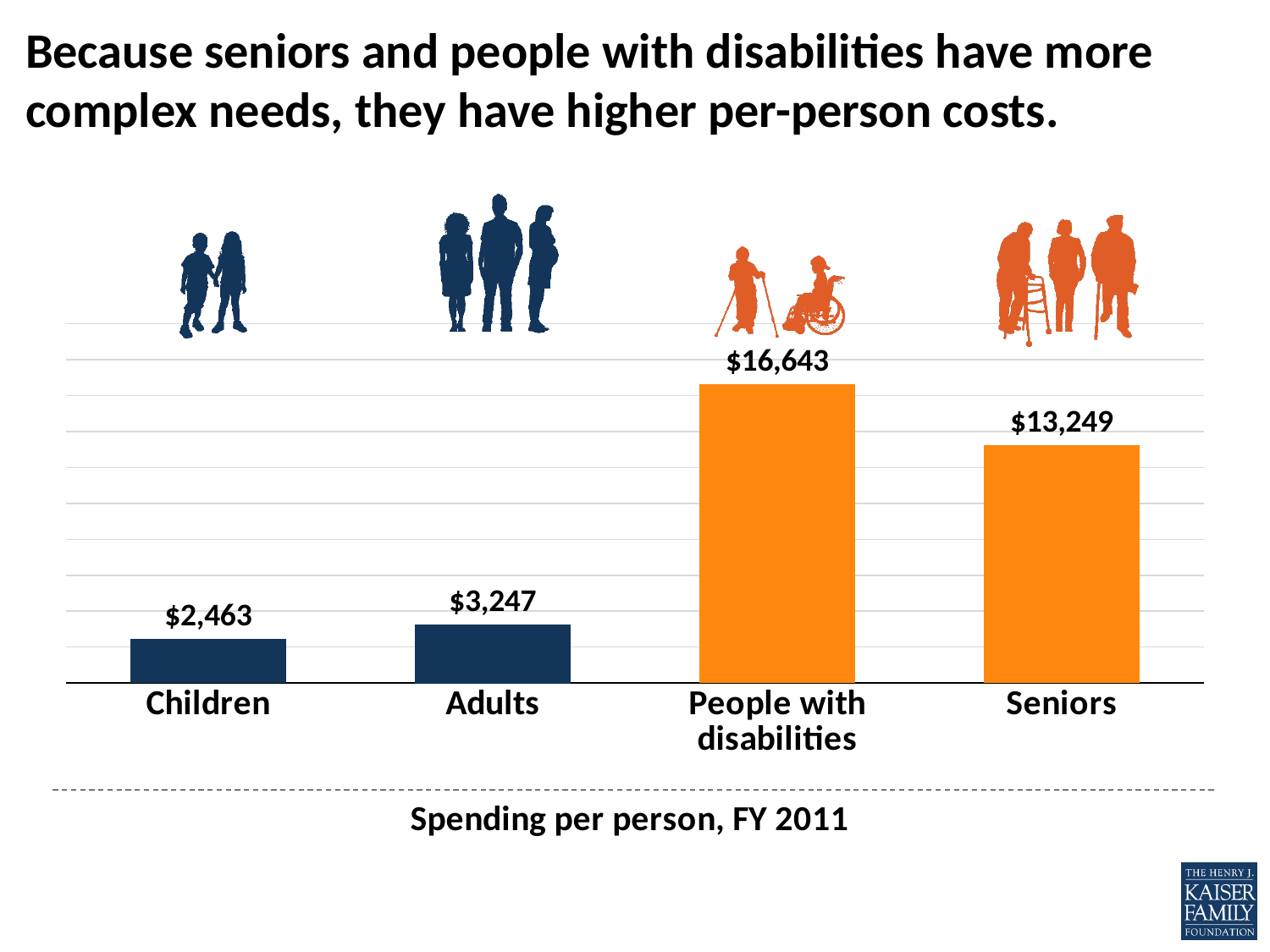
What is the difference in spending per person between People with disabilities and Seniors? $3,394 Which has higher spending per person, Seniors or Adults? Seniors Which category has the highest spending per person? People with disabilities What is the caption below the chart? Spending per person, FY 2011 What is the difference in spending per person between Adults and Children? $784 Which category has the lowest spending per person? Children What is the spending per person for Children? $2,463 What is the spending per person for People with disabilities? $16,643 What kind of chart is shown on the slide? Bar chart What is the spending per person for Adults? $3,247 How many categories are shown in the chart? 4 What is the spending per person for Seniors? $13,249